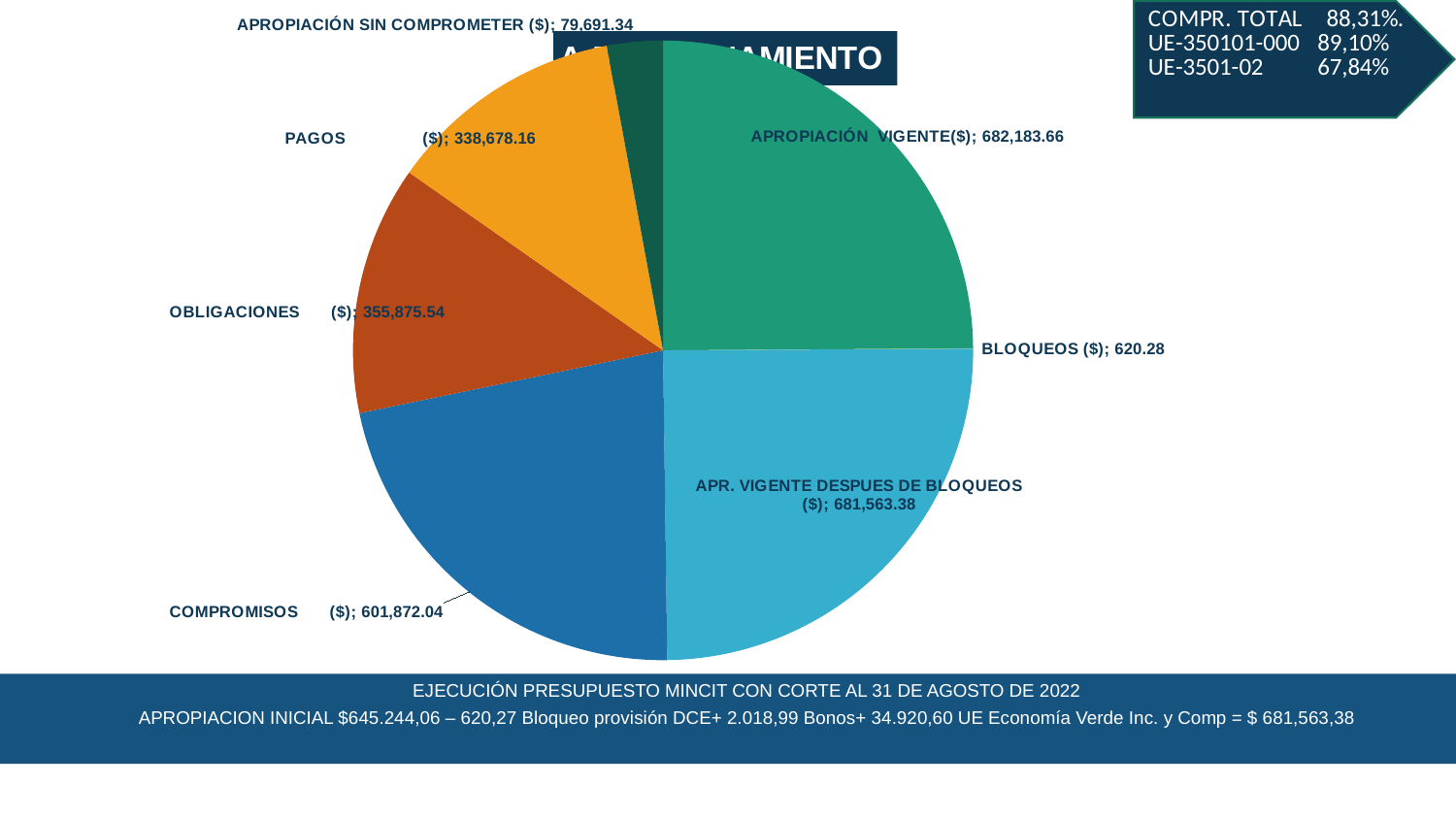
Which slice of the pie chart has the smallest value? BLOQUEOS ($) What is the difference between the COMPROMISOS ($) value and the OBLIGACIONES ($) value in the pie chart? 245,996.50 What is the value shown for PAGOS ($) in the pie chart? 338,678.16 What is the value shown for APROPIACIÓN VIGENTE ($) in the pie chart? 682,183.66 What is the difference between the OBLIGACIONES ($) value and the PAGOS ($) value in the pie chart? 17,197.38 What is the value shown for COMPROMISOS ($) in the pie chart? 601,872.04 Which is larger in the pie chart, COMPROMISOS ($) or OBLIGACIONES ($)? COMPROMISOS ($) What is the value shown for BLOQUEOS ($) in the pie chart? 620.28 What colour is the COMPROMISOS ($) slice in the pie chart? Blue How many slices does the pie chart have? 7 What is the value shown for APROPIACIÓN SIN COMPROMETER ($) in the pie chart? 79,691.34 What kind of chart is shown on the slide? Pie chart